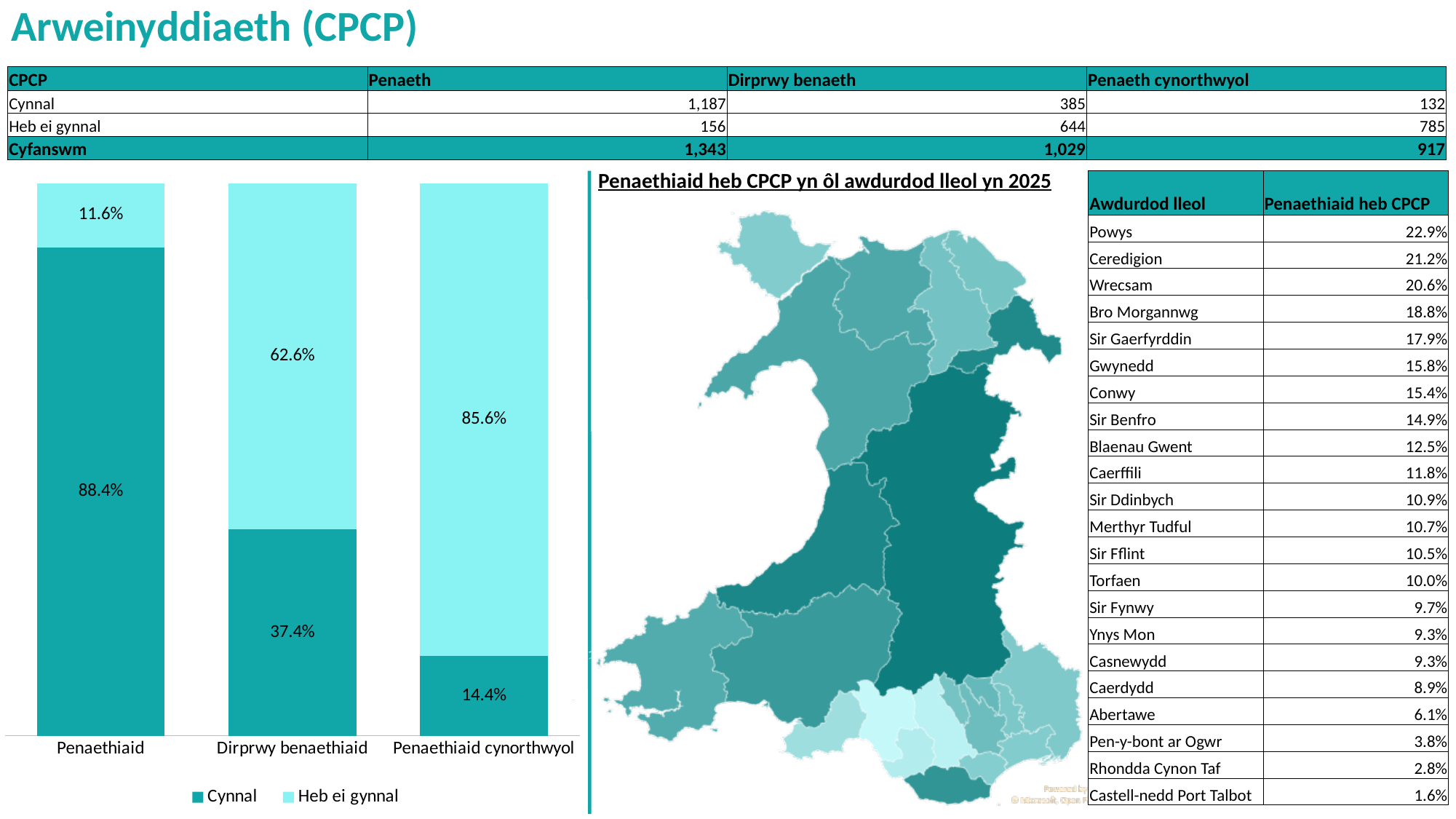
In the stacked bar chart on the left, what is the Heb ei gynnal value for Penaethiaid? 11.6% In the stacked bar chart on the left, what is the Heb ei gynnal value for Dirprwy benaethiaid? 62.6% What kind of chart is the chart on the left of the slide? Stacked bar chart In the stacked bar chart on the left, which category has the lowest Cynnal share? Penaethiaid cynorthwyol How many categories are shown on the x axis of the stacked bar chart on the left? 3 In the stacked bar chart on the left, what is the difference between the Cynnal value for Penaethiaid and the Cynnal value for Dirprwy benaethiaid? 51.0 percentage points In the stacked bar chart on the left, what is the Cynnal value for Penaethiaid cynorthwyol? 14.4% How many series does the legend of the stacked bar chart on the left list? 2 In the stacked bar chart on the left, for Dirprwy benaethiaid, which is larger: Cynnal or Heb ei gynnal? Heb ei gynnal In the stacked bar chart on the left, does the Cynnal share rise or fall from Penaethiaid to Penaethiaid cynorthwyol? Fall In the stacked bar chart on the left, which category has the highest Cynnal share? Penaethiaid In the stacked bar chart on the left, what is the Cynnal value for Penaethiaid? 88.4%